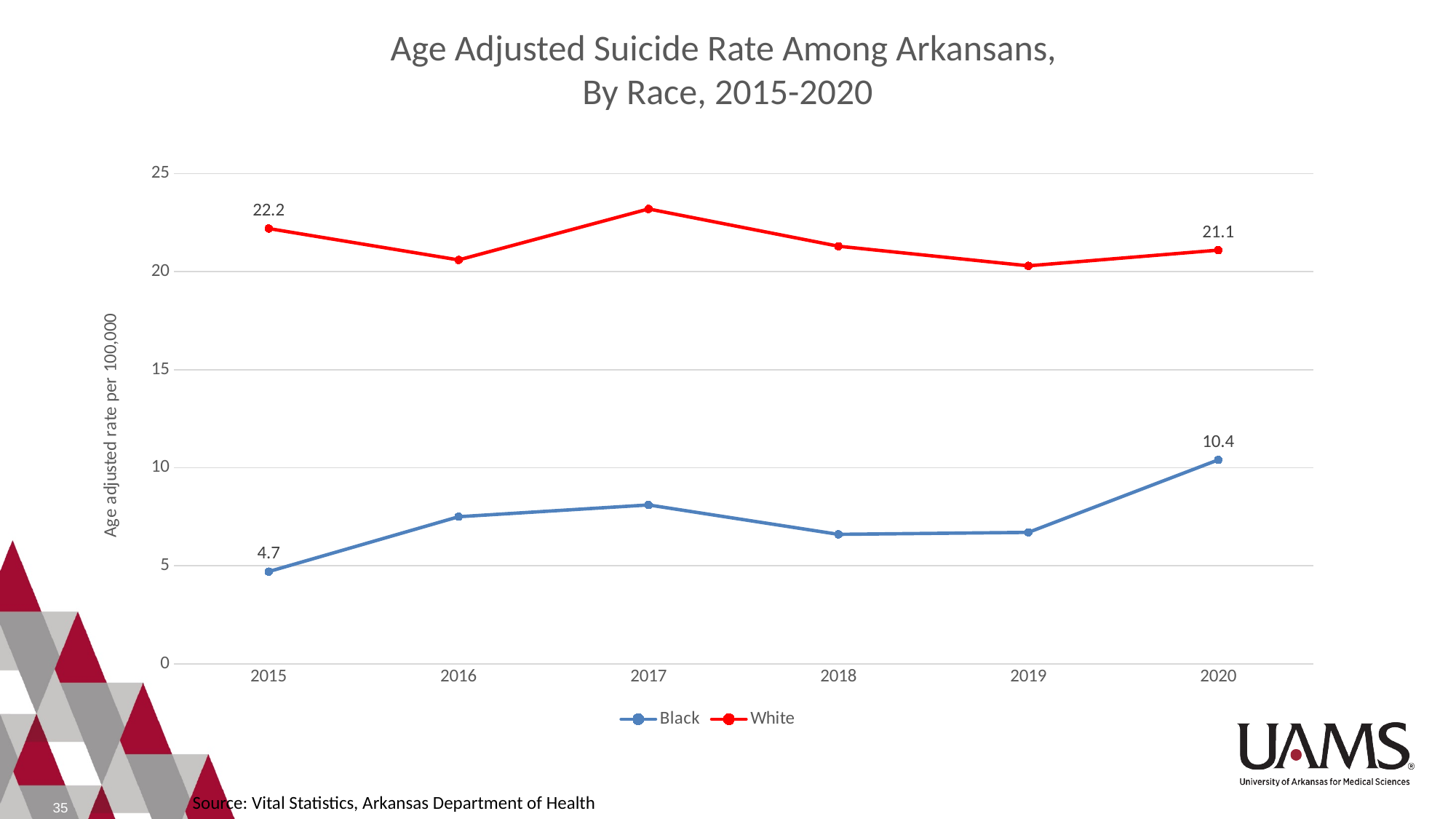
By how much did the Black suicide rate increase from 2015 to 2020? 5.7 In which year is the Black suicide rate highest? 2020 What is the difference between the White and Black suicide rates in 2015? 17.5 What kind of chart is shown on the slide? Line chart What is the age adjusted suicide rate for Black Arkansans in 2020? 10.4 Is the value for White in 2017 greater or less than 20? greater Which series has the higher value in 2020, Black or White? White How many series does the legend list? 2 In which year is the Black suicide rate lowest? 2015 What is the age adjusted suicide rate for White Arkansans in 2020? 21.1 What is the age adjusted suicide rate for Black Arkansans in 2015? 4.7 Is the value for Black in 2018 greater or less than 10? less